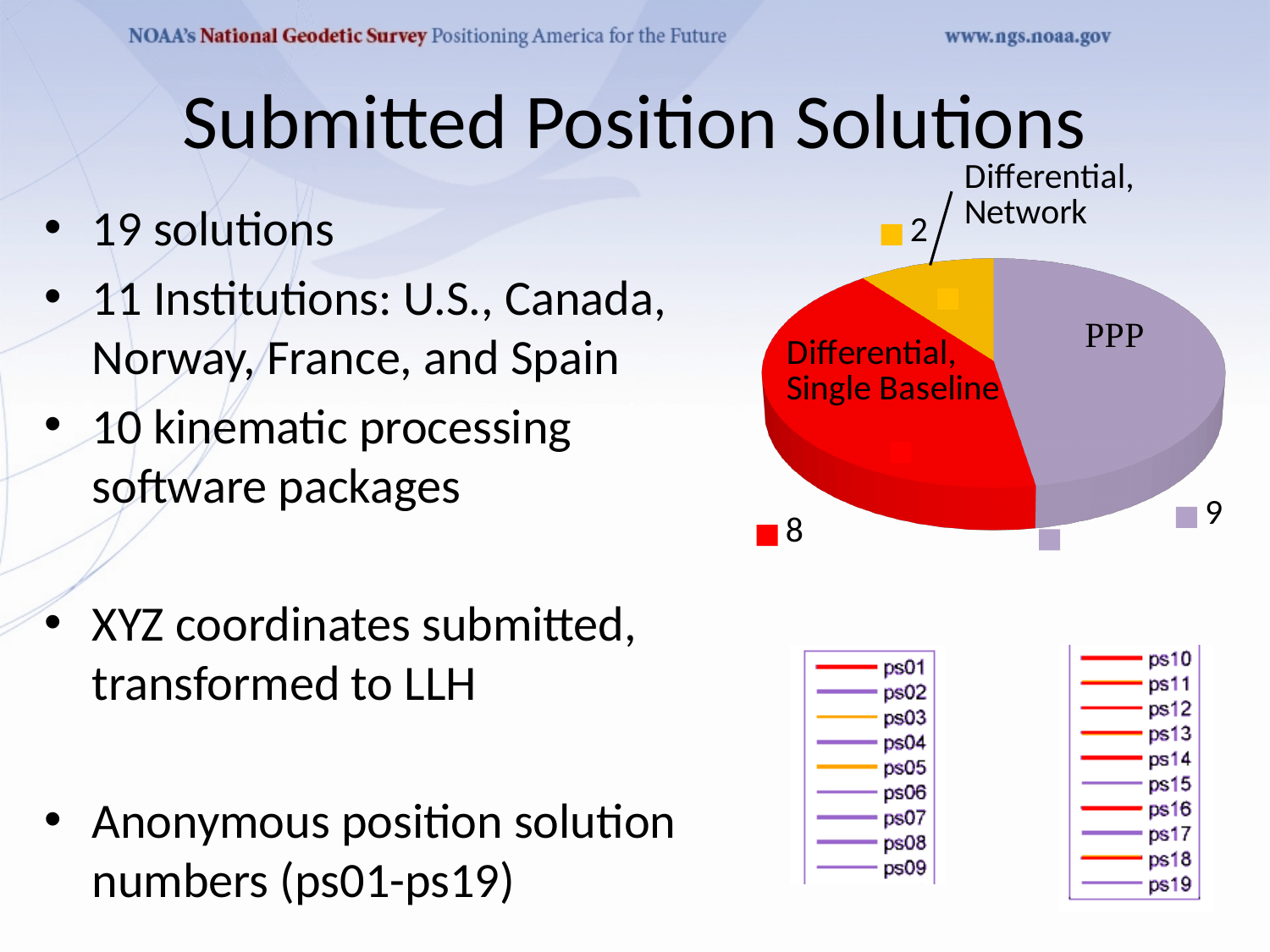
How many slices does the pie chart have? 3 What is the value of the Differential, Network slice in the pie chart? 2 What is the difference between the PPP value and the Differential, Single Baseline value in the pie chart? 1 What is the difference between the PPP value and the Differential, Network value in the pie chart? 7 What kind of chart is shown on the slide? pie chart Which category has the smallest slice in the pie chart? Differential, Network What is the total of all slices in the pie chart? 19 What colour is the PPP slice in the pie chart? purple What is the value of the PPP slice in the pie chart? 9 What is the value of the Differential, Single Baseline slice in the pie chart? 8 Which is larger in the pie chart, Differential, Single Baseline or Differential, Network? Differential, Single Baseline Which category has the largest slice in the pie chart? PPP